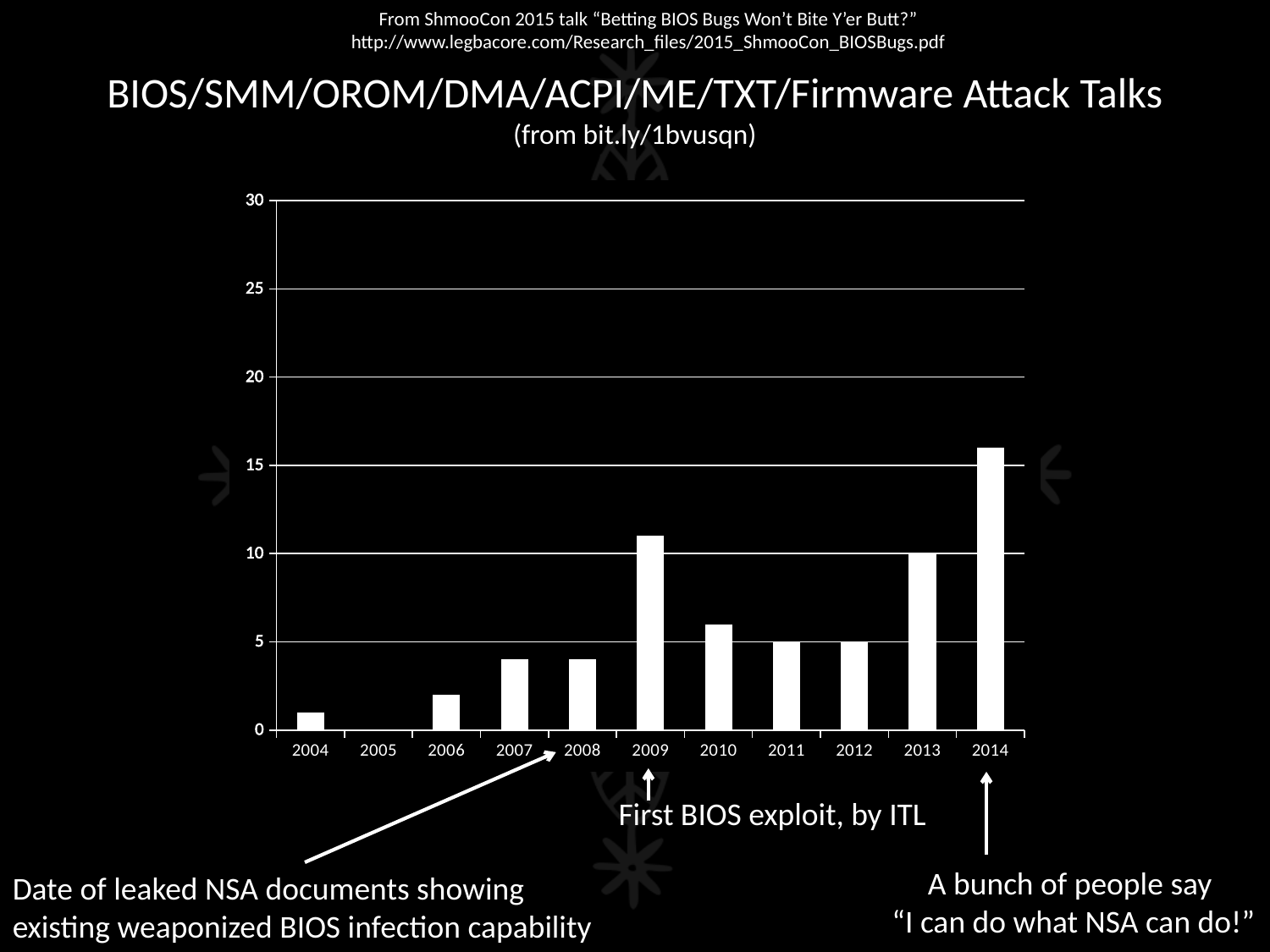
Which year has more talks, 2009 or 2010? 2009 Is the value for 2009 greater or less than 10? greater How many years are shown along the x axis of the chart? 11 Which year has the highest number of talks? 2014 What is the title of the chart? BIOS/SMM/OROM/DMA/ACPI/ME/TXT/Firmware Attack Talks Is the value for 2007 greater or less than 5? less What kind of chart is shown on the slide? bar chart What is the value for 2011? 5 What is the value for 2013? 10 Which year has the lowest number of talks? 2005 What is the value for 2012? 5 Is the value for 2014 greater or less than 15? greater